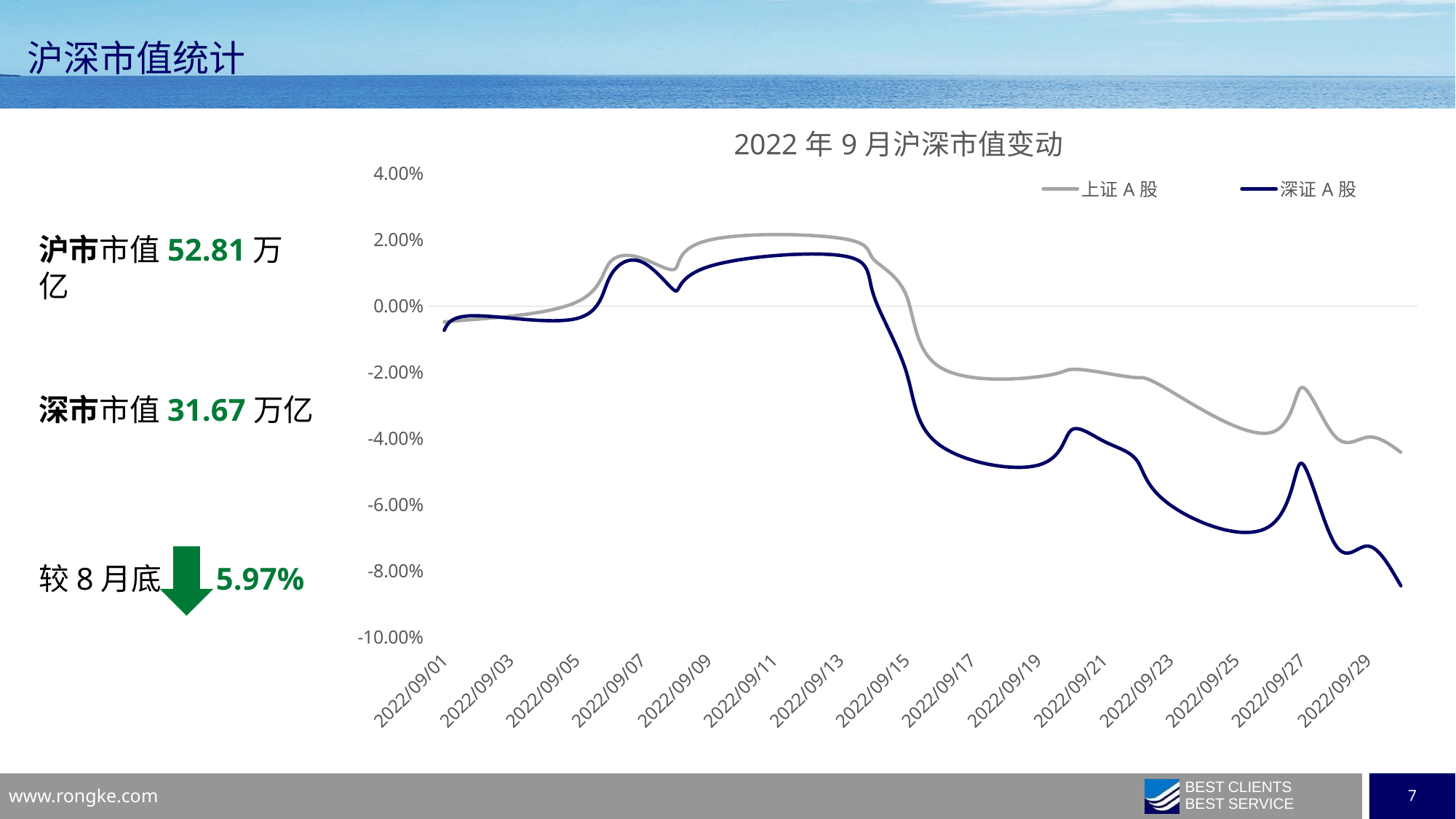
At 2022/09/29, which series has the higher value, 上证 A 股 or 深证 A 股? 上证 A 股 Which series is drawn in dark blue in the chart? 深证 A 股 Which series reaches the lowest point on the chart? 深证 A 股 Is the value for 深证 A 股 at 2022/09/17 greater or less than -4.00%? less Overall, do the values for 深证 A 股 rise or fall from 2022/09/01 to the end of the chart? fall Is the value for 上证 A 股 at 2022/09/11 greater or less than 0.00%? greater How many date labels are shown on the x axis? 15 How many series does the chart legend list? 2 Is the value for 上证 A 股 at 2022/09/17 greater or less than -4.00%? greater What is the title of the chart? 2022 年 9 月沪深市值变动 What kind of chart is shown on the slide? line chart